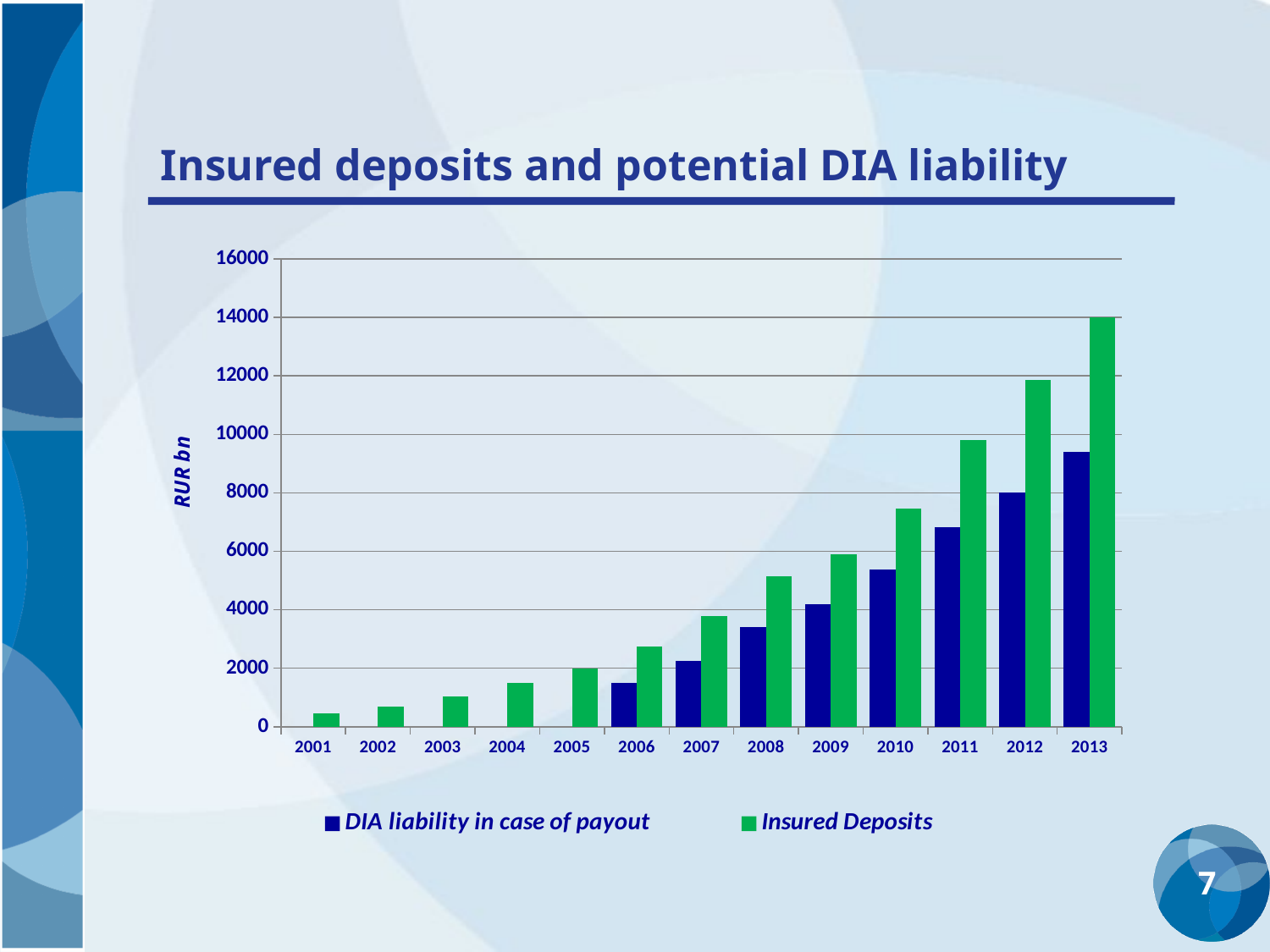
Which series is shown in green? Insured Deposits In which year is the Insured Deposits value highest? 2013 How many years are shown on the x axis? 13 Is the Insured Deposits value for 2013 greater or less than 12000? greater Is the Insured Deposits value for 2011 greater or less than 8000? greater In which year is the Insured Deposits value lowest? 2001 Do the Insured Deposits values rise or fall from 2001 to 2013? rise Is the DIA liability in case of payout value for 2010 greater or less than 6000? less What is the label on the y axis? RUR bn How many series does the legend list? 2 In 2013, which is larger: Insured Deposits or DIA liability in case of payout? Insured Deposits What kind of chart is shown on the slide? bar chart